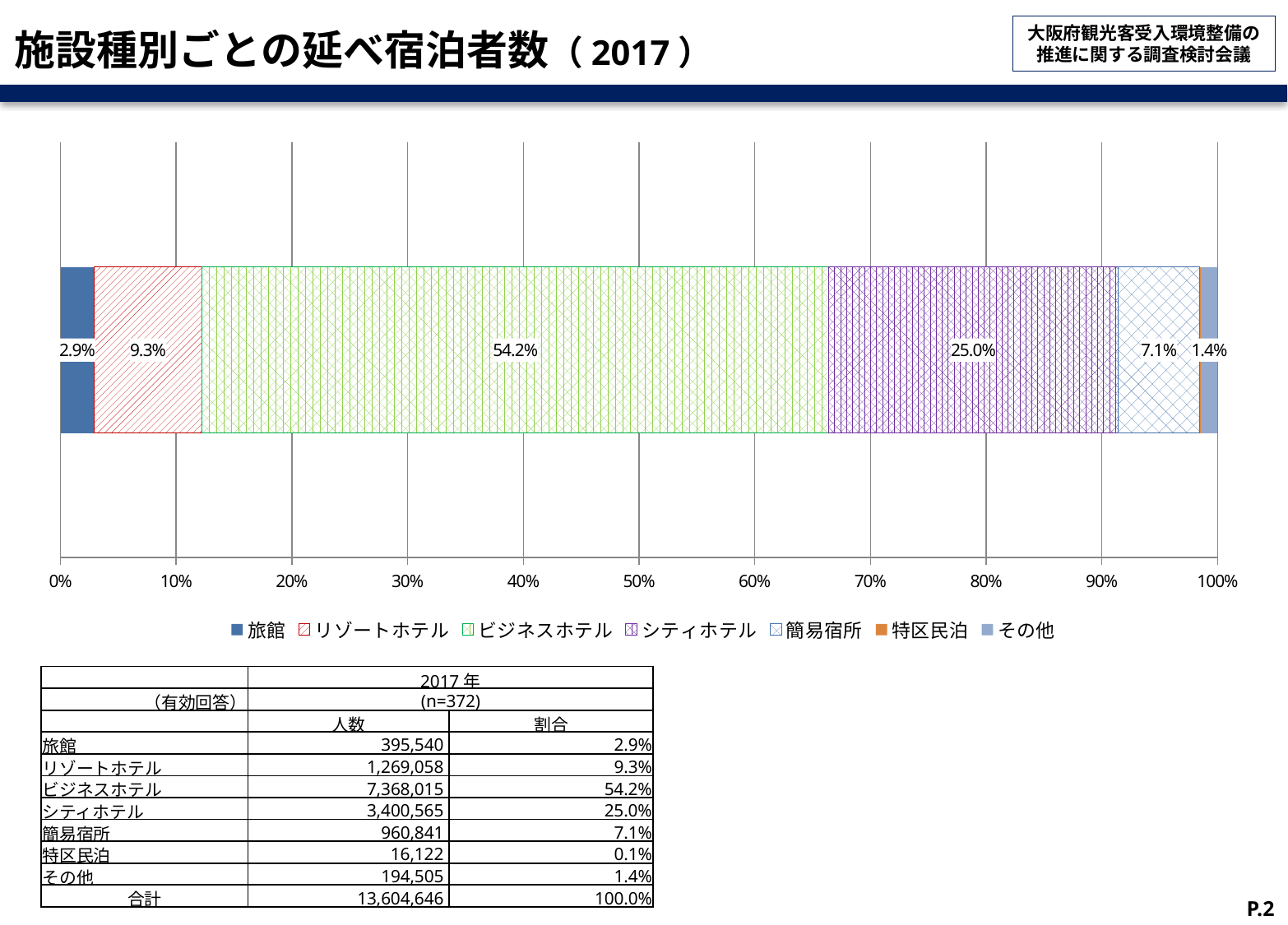
What is the difference in percentage points between the ビジネスホテル and シティホテル segments? 29.2% Which segment is larger in the bar chart, リゾートホテル or 簡易宿所? リゾートホテル What percentage does the ビジネスホテル segment show in the bar chart? 54.2% What percentage does the リゾートホテル segment show in the bar chart? 9.3% How many series does the legend of the bar chart list? 7 What kind of chart is shown on the slide? Stacked bar chart Which of the labeled segments in the bar chart has the smallest share? その他 What percentage does the シティホテル segment show in the bar chart? 25.0% What percentage does the 簡易宿所 segment show in the bar chart? 7.1% Which facility type has the largest share in the bar chart? ビジネスホテル What percentage does the 旅館 segment show in the bar chart? 2.9% What is the maximum value shown on the horizontal axis of the bar chart? 100%